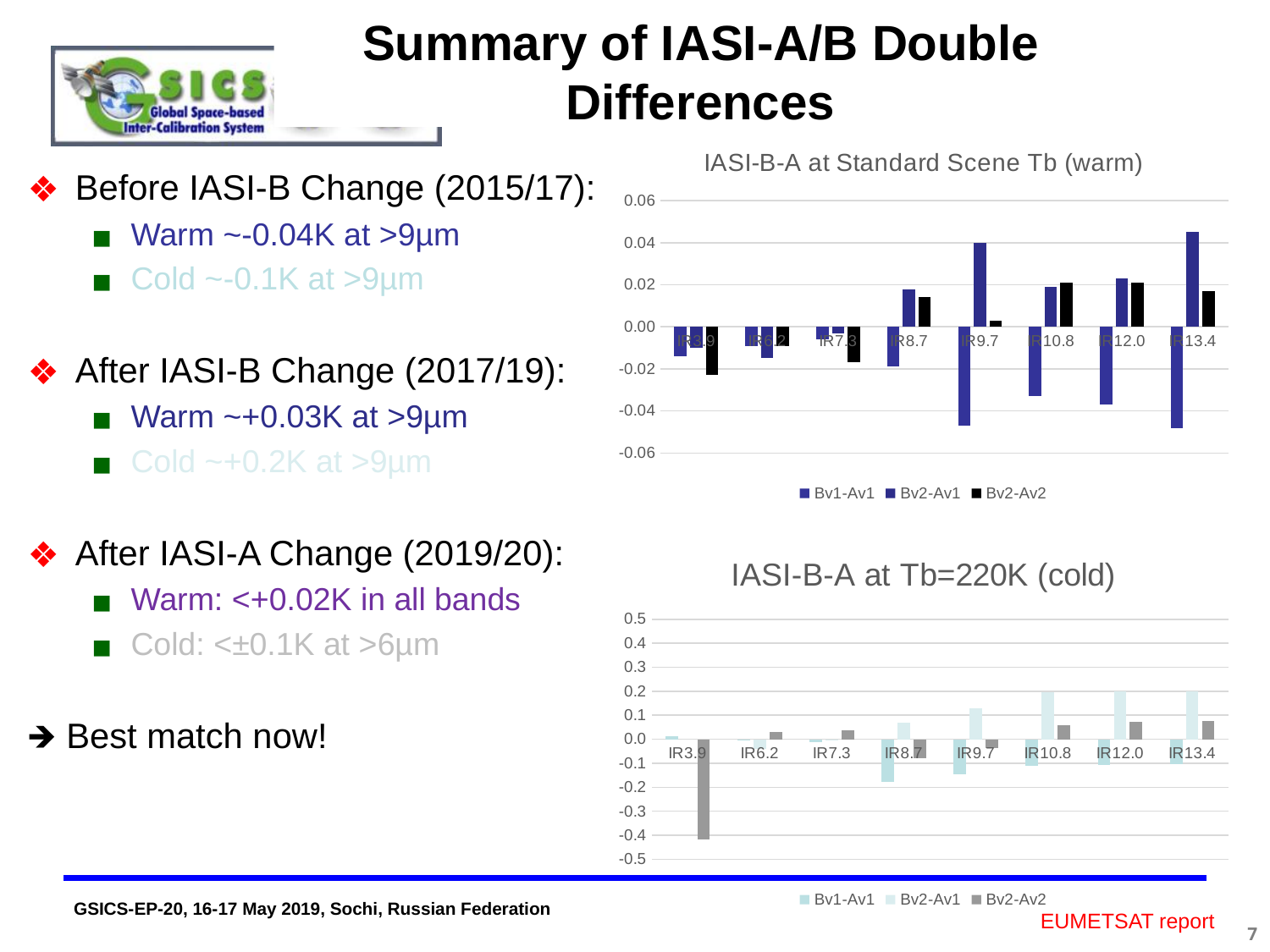
In the 'IASI-B-A at Tb=220K (cold)' chart, which category has the lowest Bv2-Av2 value? IR3.9 In the 'IASI-B-A at Standard Scene Tb (warm)' chart, which category has the highest Bv2-Av1 value? IR13.4 In the 'IASI-B-A at Tb=220K (cold)' chart, is the Bv2-Av2 value for IR3.9 greater or less than -0.3? less In the 'IASI-B-A at Tb=220K (cold)' chart, which is larger, the Bv2-Av1 value for IR9.7 or for IR8.7? IR9.7 In the 'IASI-B-A at Standard Scene Tb (warm)' chart, is the Bv1-Av1 value for IR9.7 greater or less than -0.04? less In the 'IASI-B-A at Standard Scene Tb (warm)' chart, is the Bv2-Av2 value for IR10.8 greater or less than 0.00? greater How many series does the legend of the 'IASI-B-A at Tb=220K (cold)' chart list? 3 What kind of chart is the 'IASI-B-A at Standard Scene Tb (warm)' chart? bar chart What is the title of the lower chart on the slide? IASI-B-A at Tb=220K (cold) How many categories are shown on the x axis of the 'IASI-B-A at Standard Scene Tb (warm)' chart? 8